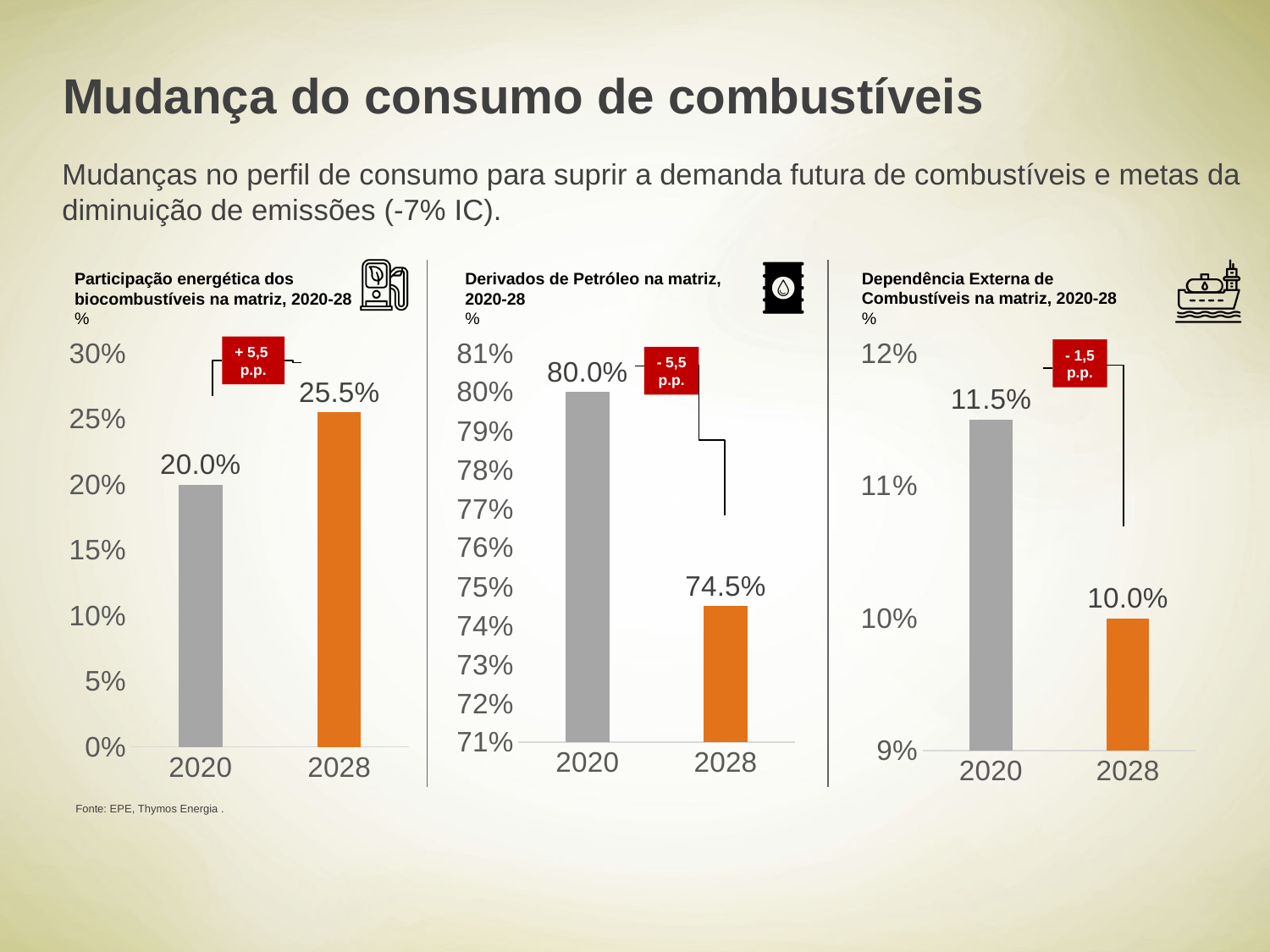
How many bars does the left chart (Participação energética dos biocombustíveis na matriz) show? 2 In the left chart (Participação energética dos biocombustíveis na matriz), what is the difference between the 2028 and 2020 values? 5.5 percentage points In the right chart (Dependência Externa de Combustíveis na matriz), do the values rise or fall from 2020 to 2028? fall In the left chart (Participação energética dos biocombustíveis na matriz), what is the value for 2028? 25.5% In the right chart (Dependência Externa de Combustíveis na matriz), what change in percentage points is shown in the red label? - 1,5 p.p. In the right chart (Dependência Externa de Combustíveis na matriz), what is the value for 2028? 10.0% In the middle chart (Derivados de Petróleo na matriz), what is the value for 2028? 74.5% In the middle chart (Derivados de Petróleo na matriz), which year has the higher value, 2020 or 2028? 2020 In the middle chart (Derivados de Petróleo na matriz), what is the value for 2020? 80.0% What kind of chart is the middle chart (Derivados de Petróleo na matriz)? bar chart In the left chart (Participação energética dos biocombustíveis na matriz), what is the value for 2020? 20.0% In the right chart (Dependência Externa de Combustíveis na matriz), what is the value for 2020? 11.5%